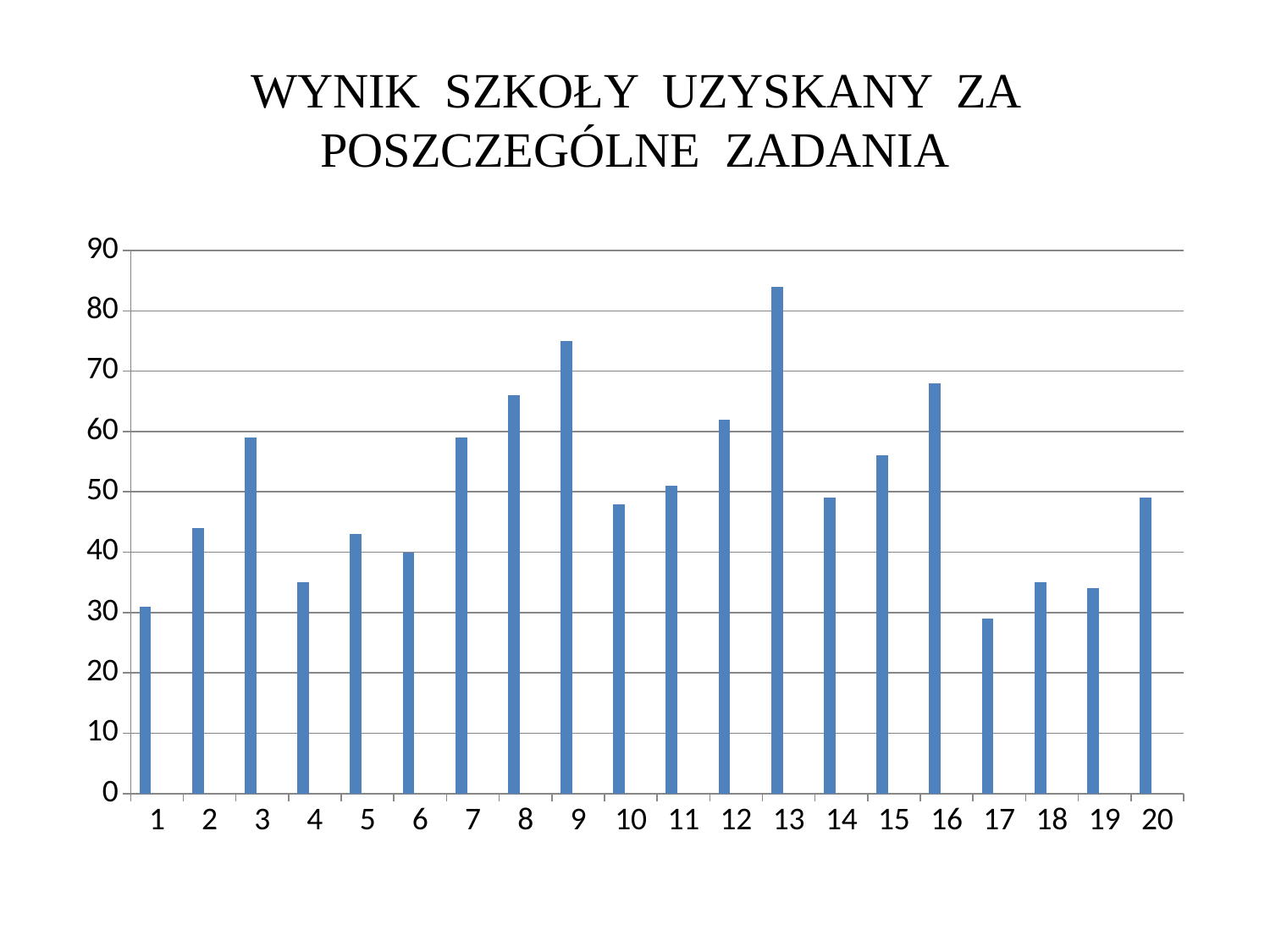
What type of chart is shown on the slide? bar chart What is the title of the chart? WYNIK SZKOŁY UZYSKANY ZA POSZCZEGÓLNE ZADANIA Which has a larger value, task 9 or task 16? task 9 Is the value for task 13 greater or less than 80? greater How many categories (tasks) are shown on the x axis of the chart? 20 Is the value for task 4 greater or less than 40? less Is the value for task 9 greater or less than 70? greater Which has a larger value, task 3 or task 4? task 3 Which task has the highest value in the chart? 13